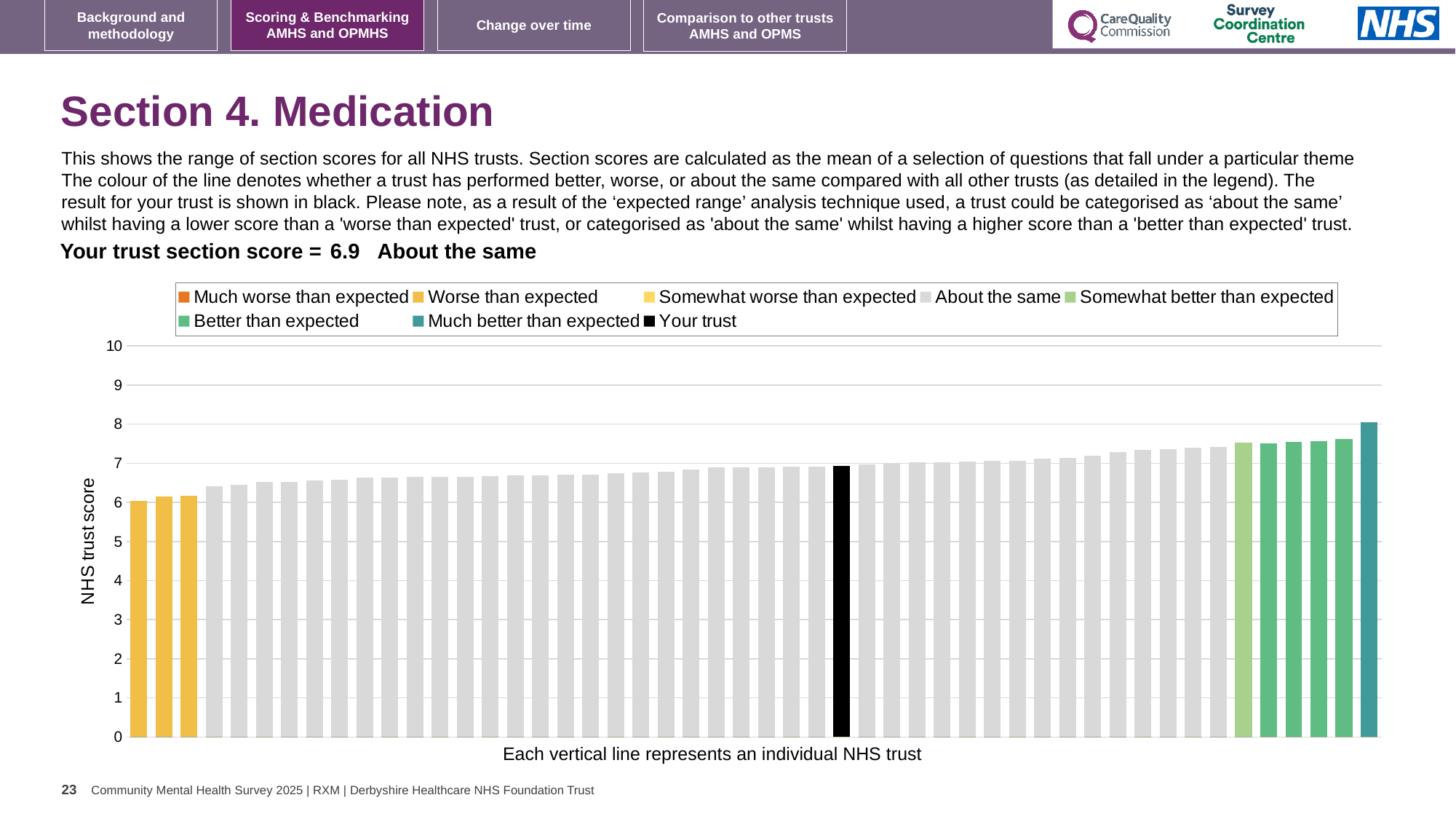
How many bars are coloured as 'Better than expected'? 4 How many bars are coloured as 'Worse than expected'? 3 Is the value of your trust's bar greater or less than 6? greater Which legend category does the tallest bar on the chart belong to? Much better than expected Do the bar values rise or fall from left to right across the chart? rise Is the value of the lowest bar on the chart greater or less than 7? less Which legend category do the lowest bars on the chart belong to? Worse than expected How many entries does the chart legend list? 8 Is your trust's bar higher or lower than the 'Much better than expected' bar? lower Which category does your trust fall into for the Medication section? About the same What is your trust's section score for Medication? 6.9 What kind of chart is shown on the slide? bar chart